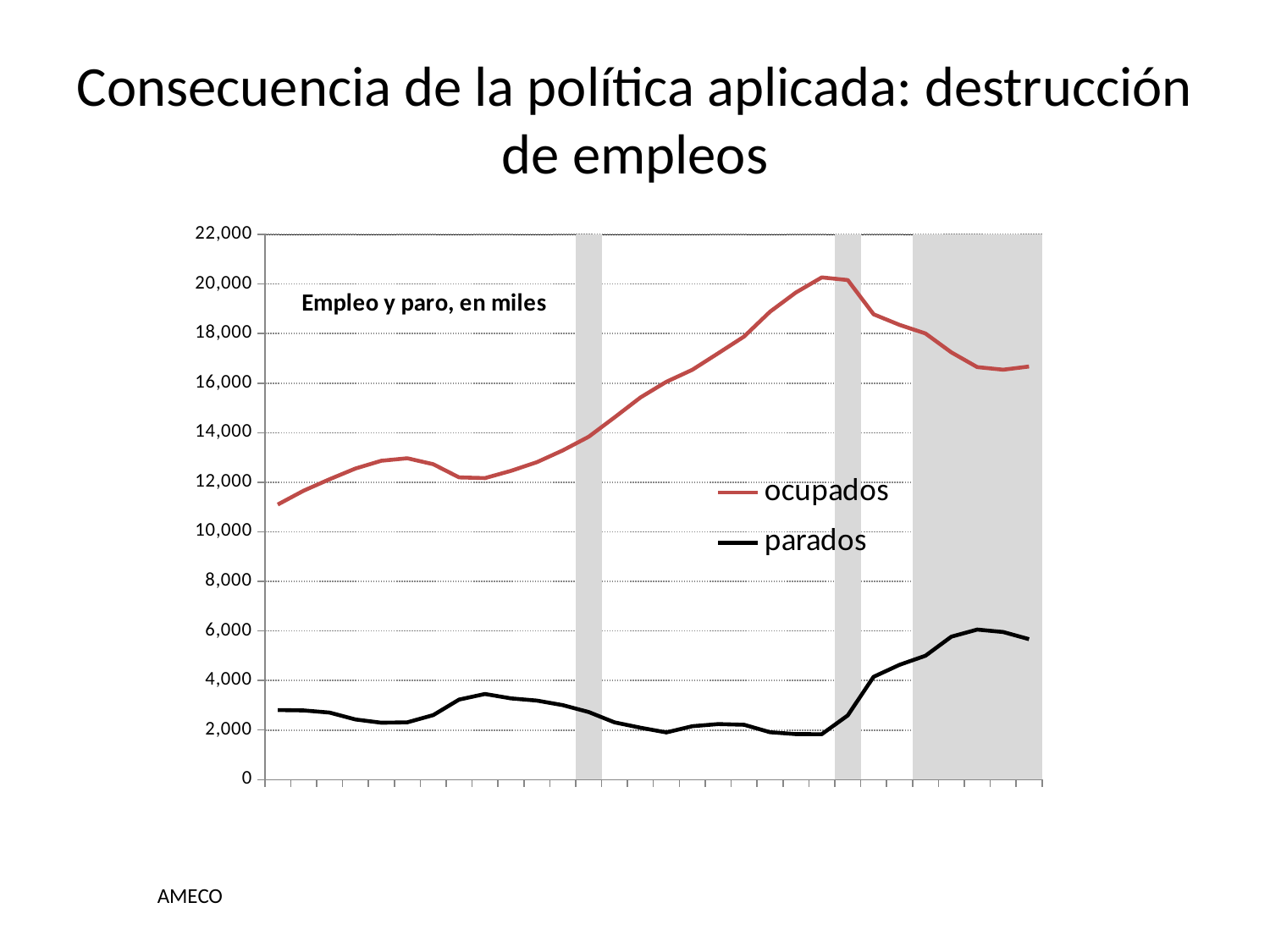
Does the parados line end higher or lower than it starts? higher How many series does the legend list? 2 Which series has higher values throughout the chart, ocupados or parados? ocupados Does the ocupados line end higher or lower than it starts? higher Is the lowest value of the ocupados line greater or less than 10,000? greater Is the highest value reached by the parados line greater or less than 4,000? greater What is the highest value shown on the vertical axis? 22,000 What is the title printed inside the chart area? Empleo y paro, en miles Is the highest value reached by the ocupados line greater or less than 18,000? greater What colour is the line for the ocupados series? red What kind of chart is shown on the slide? line chart